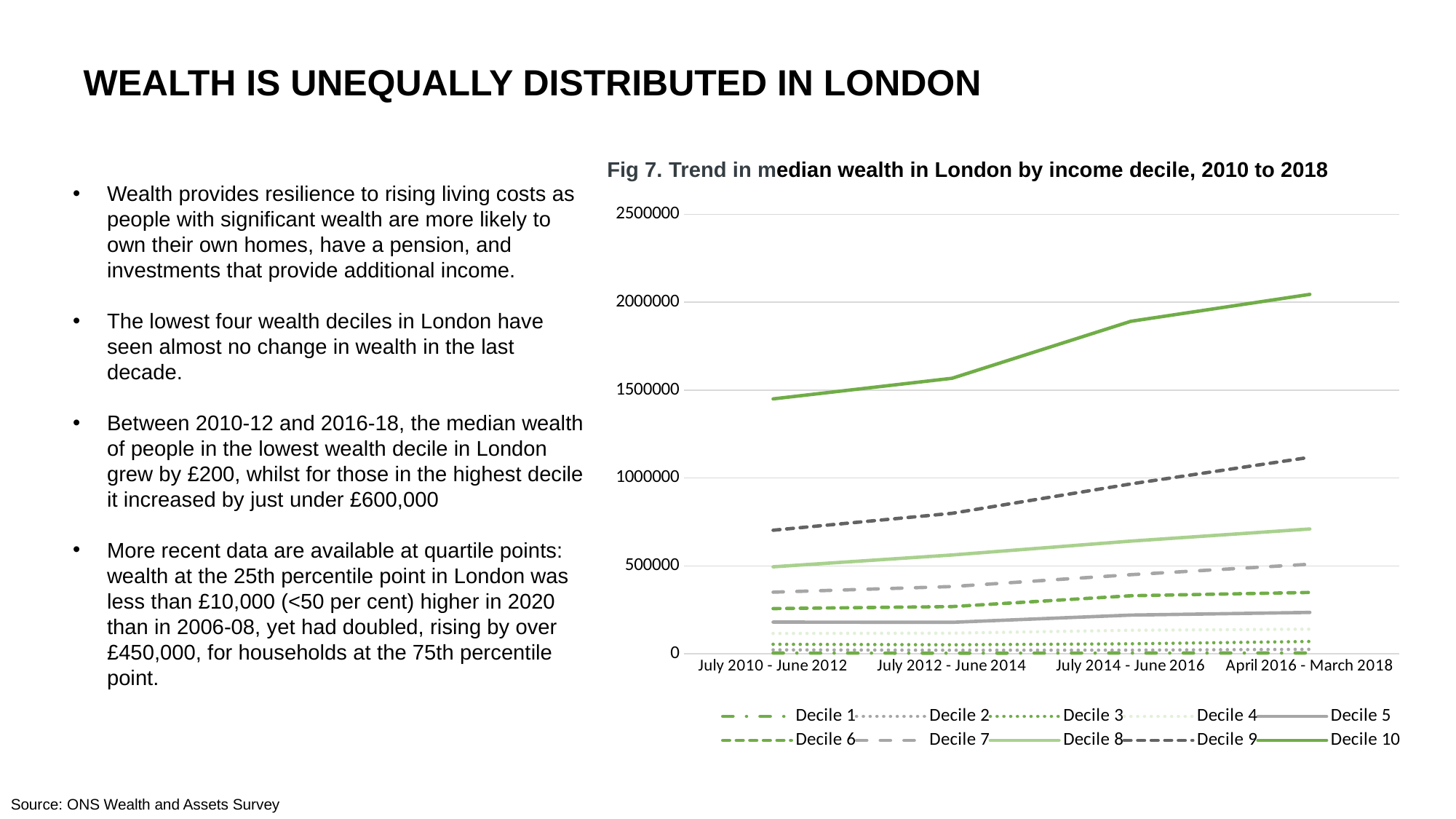
What is the title of the chart on the slide? Fig 7. Trend in median wealth in London by income decile, 2010 to 2018 Is the value for Decile 10 in July 2014 - June 2016 greater or less than 1500000? greater In April 2016 - March 2018, which is larger: the value for Decile 9 or Decile 8? Decile 9 What kind of chart is shown in Fig 7? line chart How many time periods are shown on the x axis of Fig 7? 4 How many series does the legend of Fig 7 list? 10 Is the value for Decile 9 in April 2016 - March 2018 greater or less than 1000000? greater Is the value for Decile 8 in April 2016 - March 2018 greater or less than 500000? greater Which decile has the lowest median wealth in Fig 7? Decile 1 Which decile has the highest median wealth across all periods in Fig 7? Decile 10 Does the median wealth for Decile 10 rise or fall from July 2010 - June 2012 to April 2016 - March 2018? rise